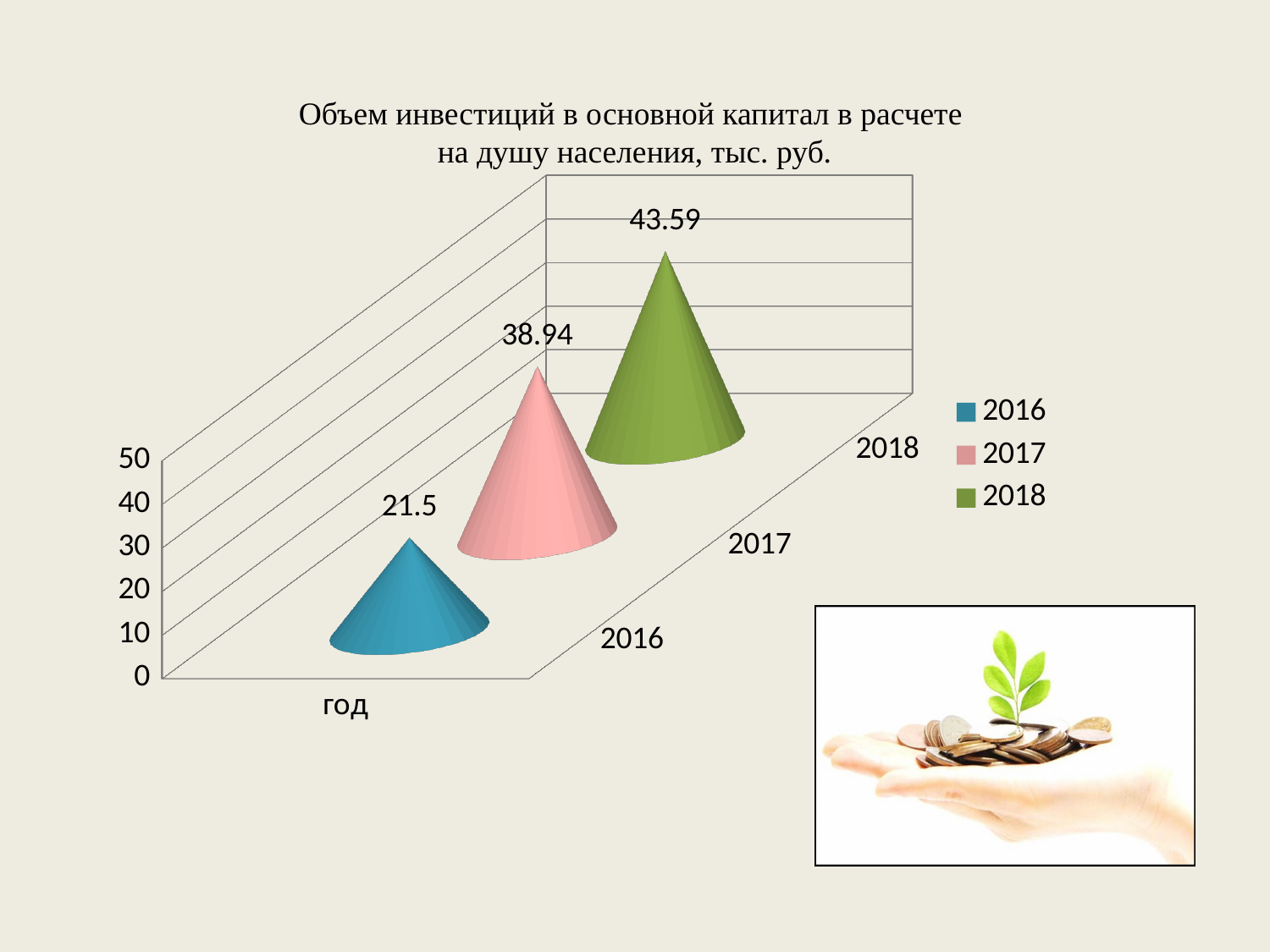
Which year has the lowest value? 2016 Is the value for 2016 greater or less than 30? less What is the value shown for 2018? 43.59 What is the difference between the values for 2017 and 2016? 17.44 What is the value shown for 2016? 21.5 Which is larger, the value for 2016 or the value for 2017? 2017 How many entries does the legend list? 3 What is the difference between the values for 2018 and 2017? 4.65 How many years are plotted on the chart? 3 What is the value shown for 2017? 38.94 Which year has the highest value? 2018 Do the values rise or fall from 2016 to 2018? rise